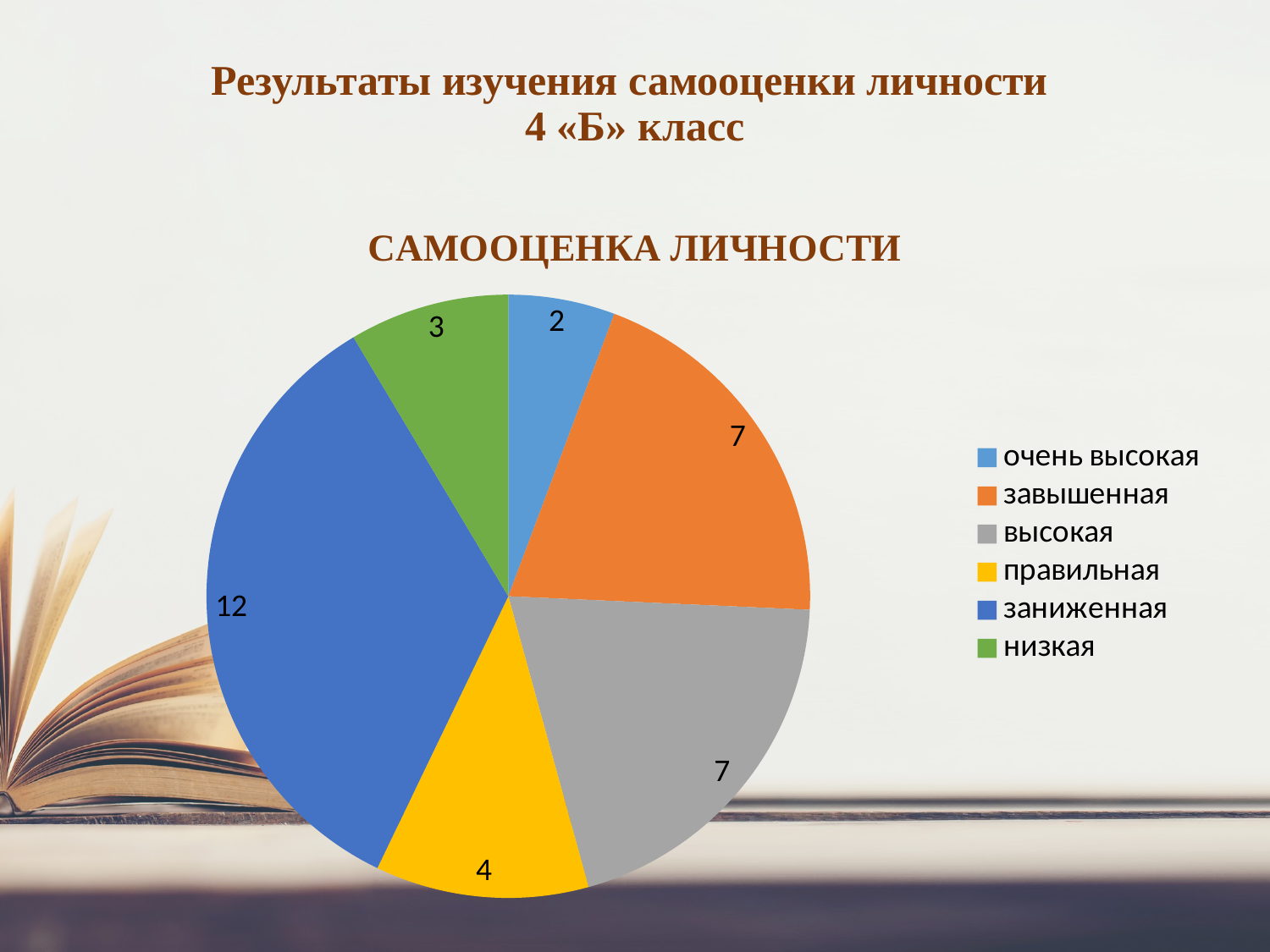
How many slices does the pie chart have? 6 Which category has the smallest slice? очень высокая Which category has the largest slice? заниженная What is the value for правильная? 4 Which is larger, the value for низкая or the value for правильная? правильная What is the value for низкая? 3 What kind of chart is shown on the slide? pie chart What is the value for очень высокая? 2 What is the value for заниженная? 12 What is the difference between the values for заниженная and правильная? 8 What share of the pie does завышенная represent? 20% What is the chart's title? САМООЦЕНКА ЛИЧНОСТИ